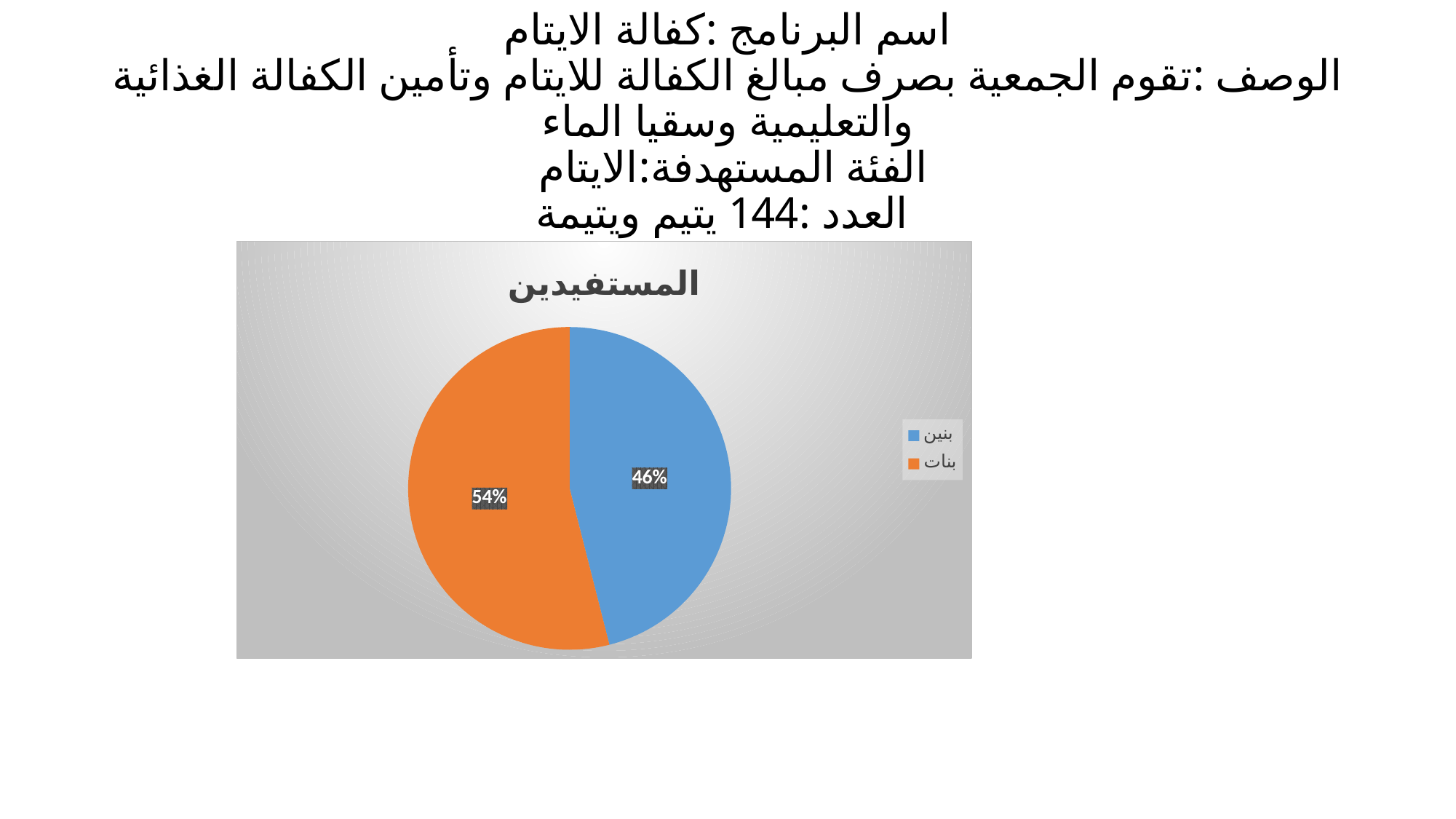
What kind of chart is shown on the slide? pie chart What share of the pie does the بنين slice represent? 46% How many entries does the legend list? 2 Which is larger, the share for بنين or the share for بنات? بنات What colour is the slice for بنات? orange What percentage of the pie is labelled for بنين? 46% Which slice of the pie is the largest? بنات What is the difference in percentage points between the بنات slice and the بنين slice? 8 Which slice of the pie is the smallest? بنين How many slices does the pie chart have? 2 What is the title of the chart? المستفيدين What percentage of the pie is labelled for بنات? 54%